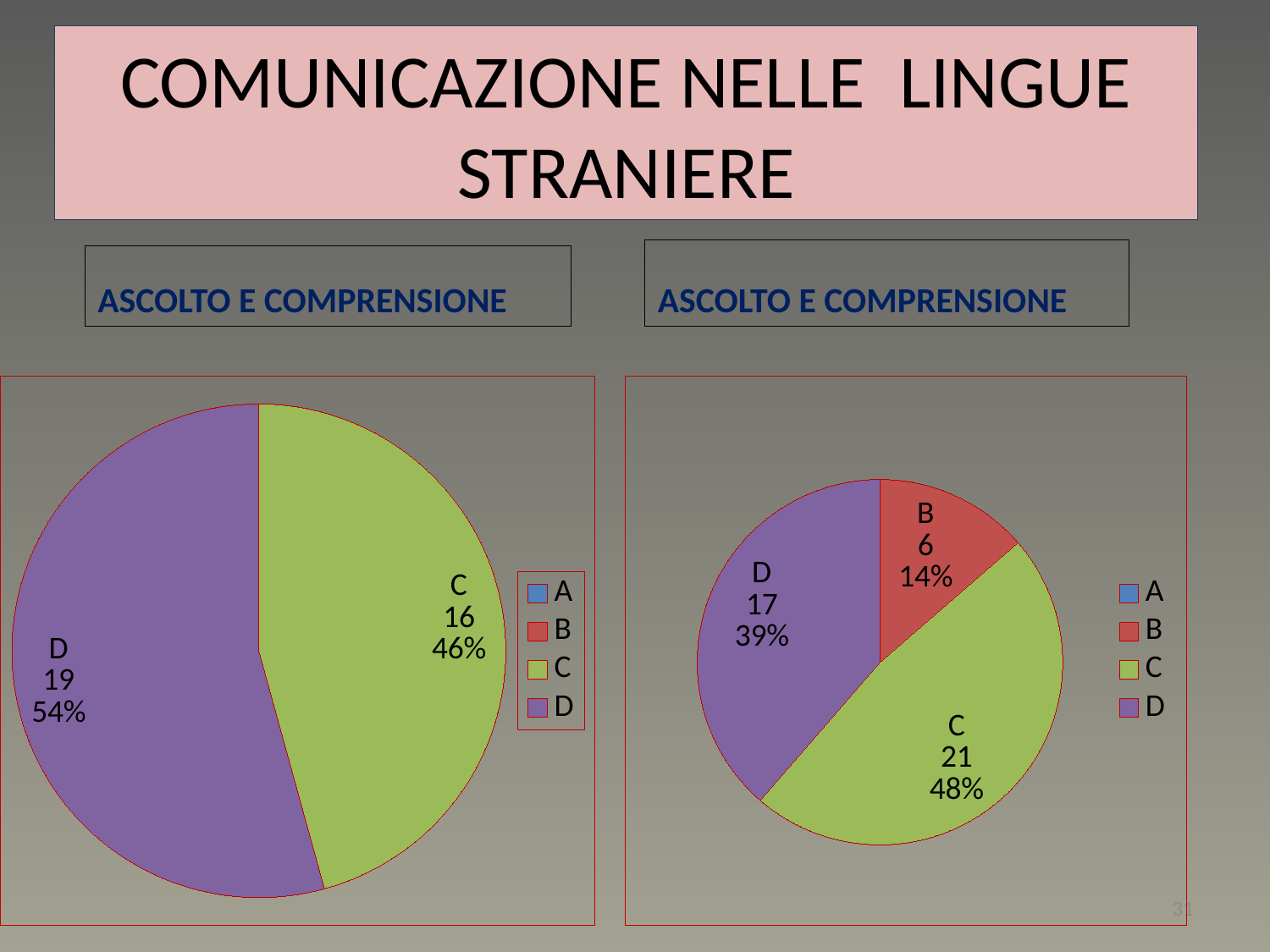
In the left pie chart, what percentage share does category C have? 46% In the left pie chart, what is the value for category D? 19 In the left pie chart, what is the difference between the values for D and C? 3 In the left pie chart, which category has the larger slice, C or D? D What type of chart is shown on the left side of the slide? Pie chart How many entries does the legend of the left pie chart list? 4 In the right pie chart, which category has the smallest slice? B How many slices with data labels does the right pie chart show? 3 In the right pie chart, what is the value for category C? 21 In the right pie chart, what percentage share does category B have? 14% In the right pie chart, which category has the largest slice? C In the right pie chart, what is the difference between the values for C and D? 4